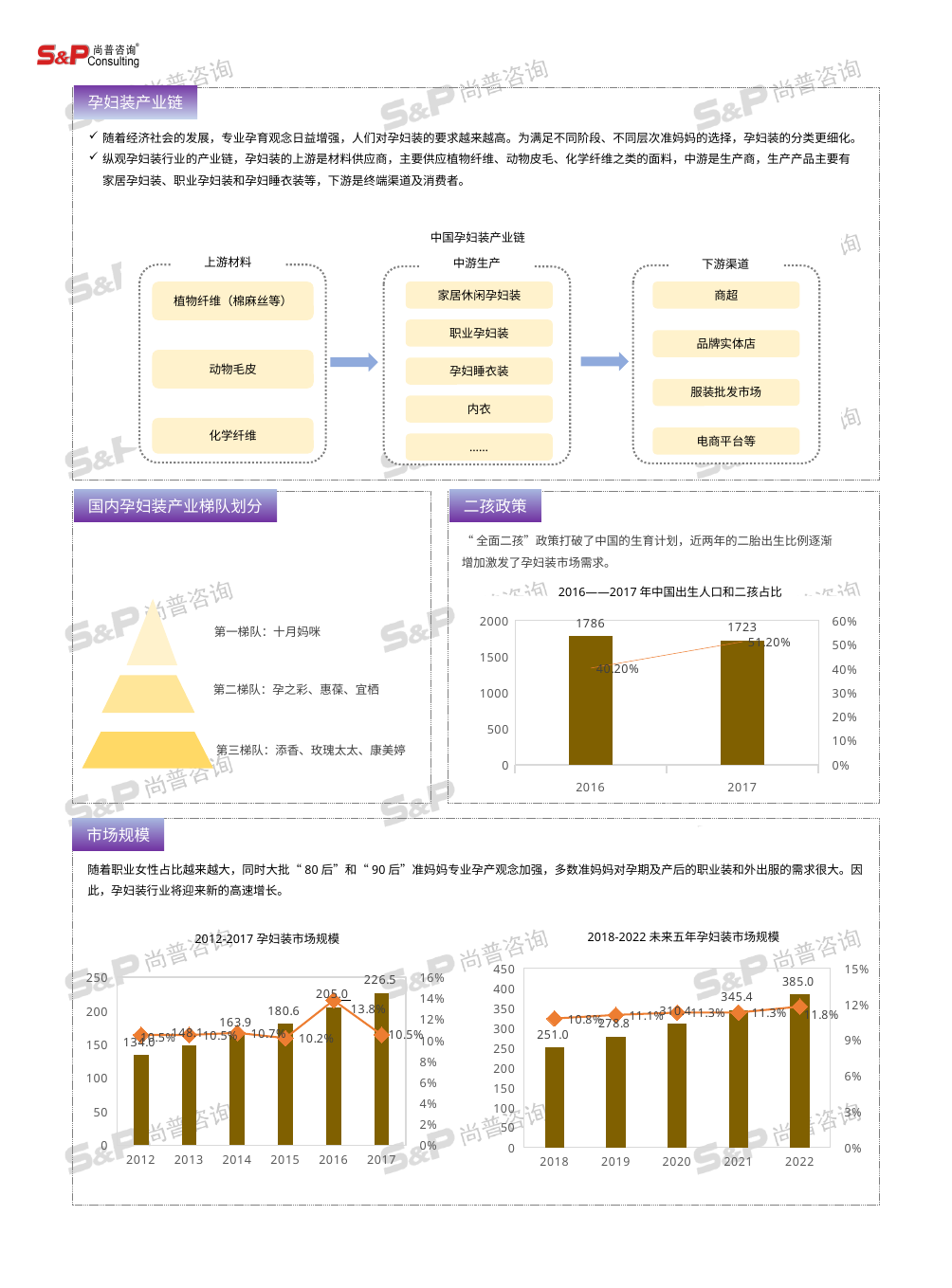
In the chart titled 2012-2017 孕妇装市场规模, which year has the highest bar value? 2017 In the chart titled 2018-2022 未来五年孕妇装市场规模, what is the difference between the bar values for 2022 and 2018? 134.0 In the chart titled 2016——2017 年中国出生人口和二孩占比, what is the bar value for 2016? 1786 In the chart titled 2012-2017 孕妇装市场规模, what is the bar value for 2012? 134.0 In the chart titled 2016——2017 年中国出生人口和二孩占比, what is the difference between the bar values for 2016 and 2017? 63 In the chart titled 2012-2017 孕妇装市场规模, do the bar values rise or fall from 2012 to 2017? rise In the chart titled 2016——2017 年中国出生人口和二孩占比, what is the line value for 2017? 51.20% In the chart titled 2012-2017 孕妇装市场规模, what is the bar value for 2017? 226.5 In the chart titled 2016——2017 年中国出生人口和二孩占比, what is the bar value for 2017? 1723 In the chart titled 2018-2022 未来五年孕妇装市场规模, what is the bar value for 2022? 385.0 In the chart titled 2012-2017 孕妇装市场规模, what is the line value for 2016? 13.8% In the chart titled 2018-2022 未来五年孕妇装市场规模, how many years are shown on the x axis? 5